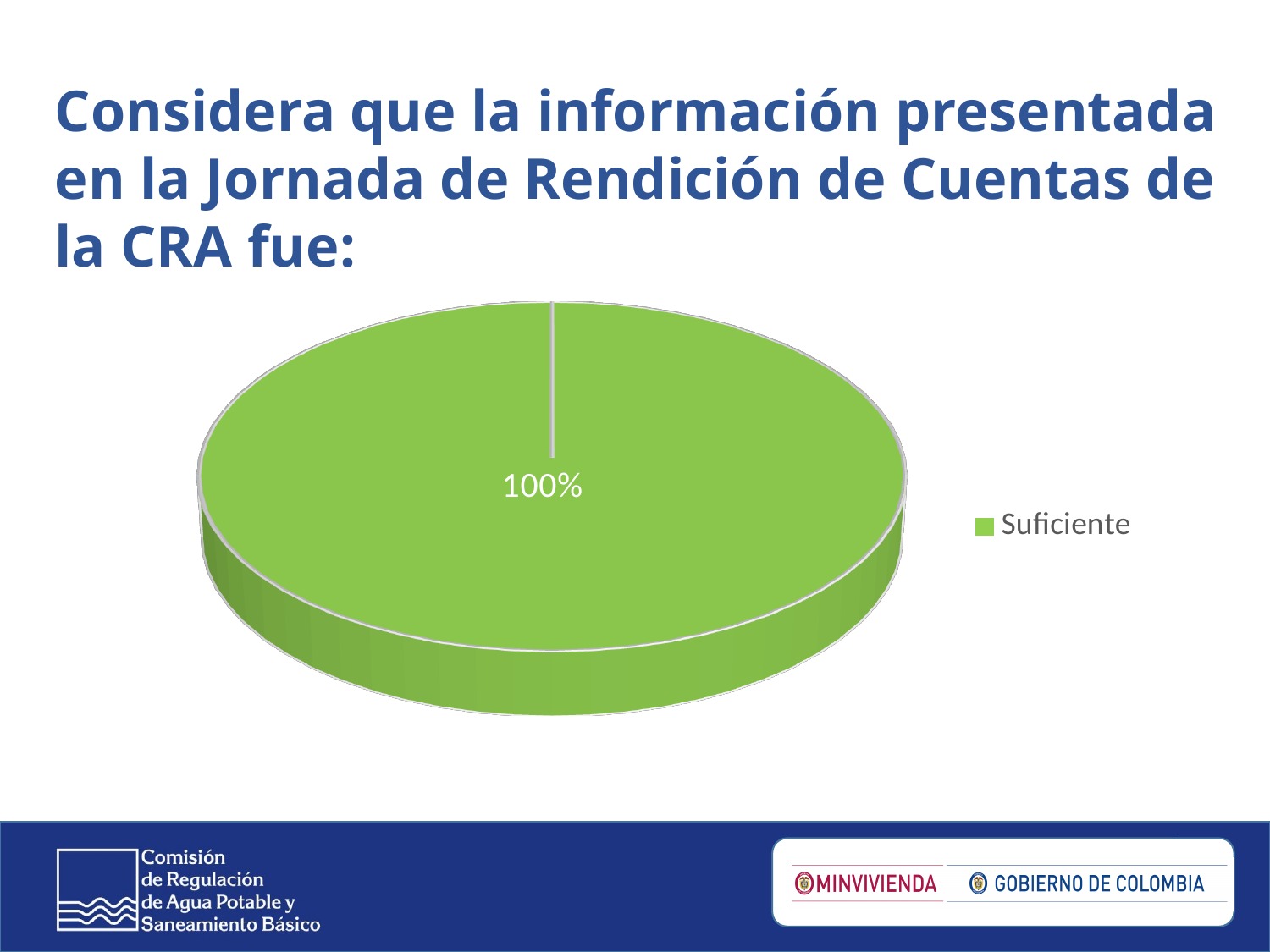
Which category is shown in the legend of the pie chart? Suficiente What colour is the "Suficiente" slice in the pie chart? green What kind of chart is shown on the slide? pie chart How many entries does the legend of the pie chart list? 1 Is the value for "Suficiente" greater or less than 50%? greater What share of the pie does the "Suficiente" slice represent? 100% How many slices does the pie chart have? 1 What value is printed on the pie chart's data label? 100%